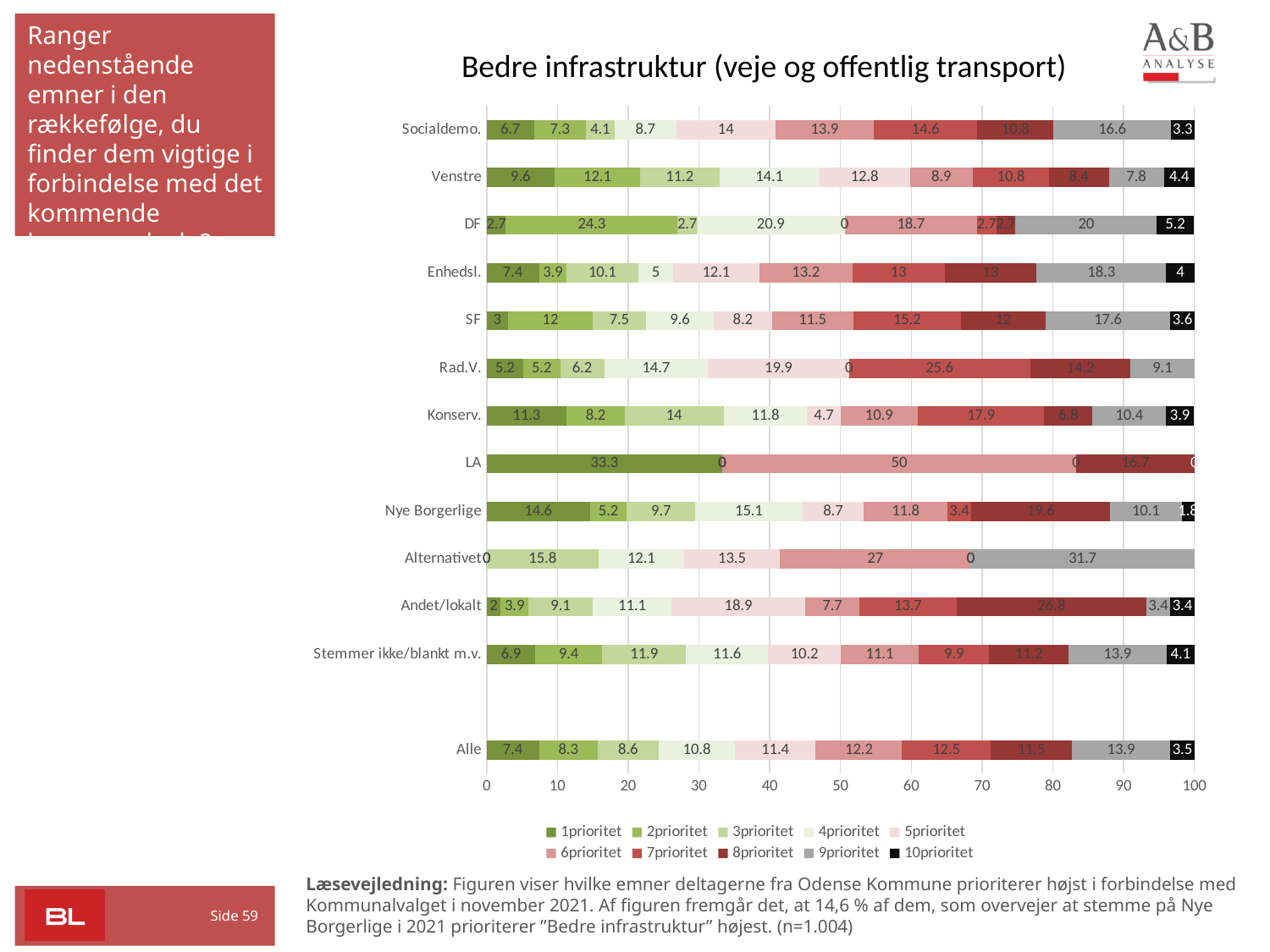
What is the 10prioritet value for DF? 5.2 How many categories are plotted on the vertical axis? 13 What is the 9prioritet value for Alternativet? 31.7 Which has the larger 1prioritet value, Konserv. or Venstre? Konserv. What is the 1prioritet value for Alle? 7.4 What is the 9prioritet value for Stemmer ikke/blankt m.v.? 13.9 Which category has the highest 1prioritet value? LA How many series does the legend list? 10 What type of chart is shown on the slide? Stacked bar chart What is the difference between the 1prioritet values for Venstre and Socialdemo.? 2.9 What is the title of the chart? Bedre infrastruktur (veje og offentlig transport) What is the 1prioritet value for Nye Borgerlige? 14.6